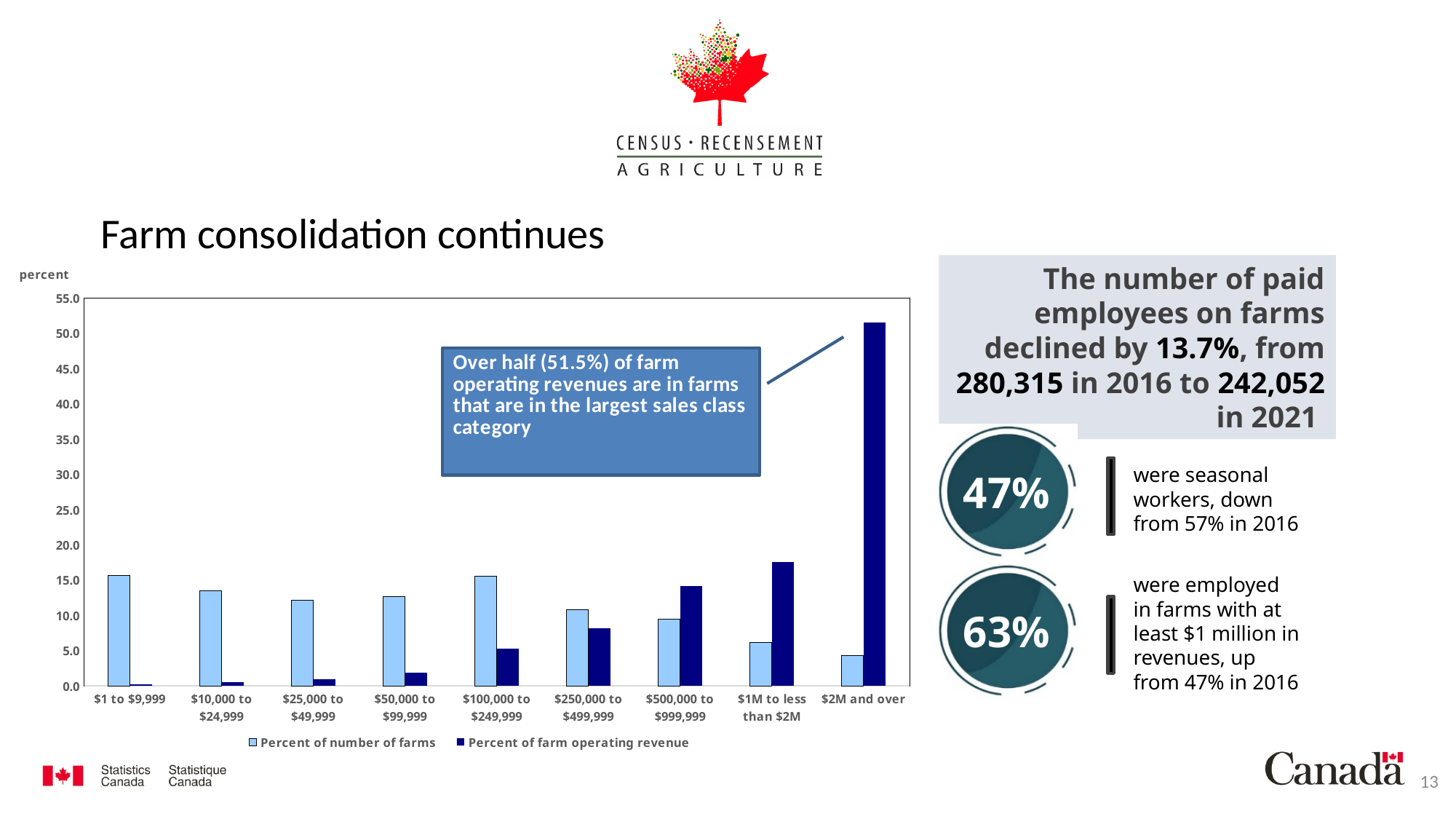
For the $500,000 to $999,999 category, which is larger: percent of number of farms or percent of farm operating revenue? Percent of farm operating revenue For the $50,000 to $99,999 category, which is larger: percent of number of farms or percent of farm operating revenue? Percent of number of farms How many sales class categories are shown on the x axis of the chart? 9 Is the percent of farm operating revenue for $1M to less than $2M greater or less than 15.0? greater What kind of chart is shown on the slide? bar chart Which sales class category has the lowest percent of number of farms? $2M and over Does the percent of farm operating revenue generally rise or fall as the sales class categories increase along the x axis? rise Is the percent of number of farms for $1 to $9,999 greater or less than 20.0? less What percent of farm operating revenue is in the $2M and over category, according to the callout on the chart? 51.5% How many series does the chart legend list? 2 Is the percent of farm operating revenue for $500,000 to $999,999 greater or less than 10.0? greater Which sales class category has the highest percent of farm operating revenue? $2M and over